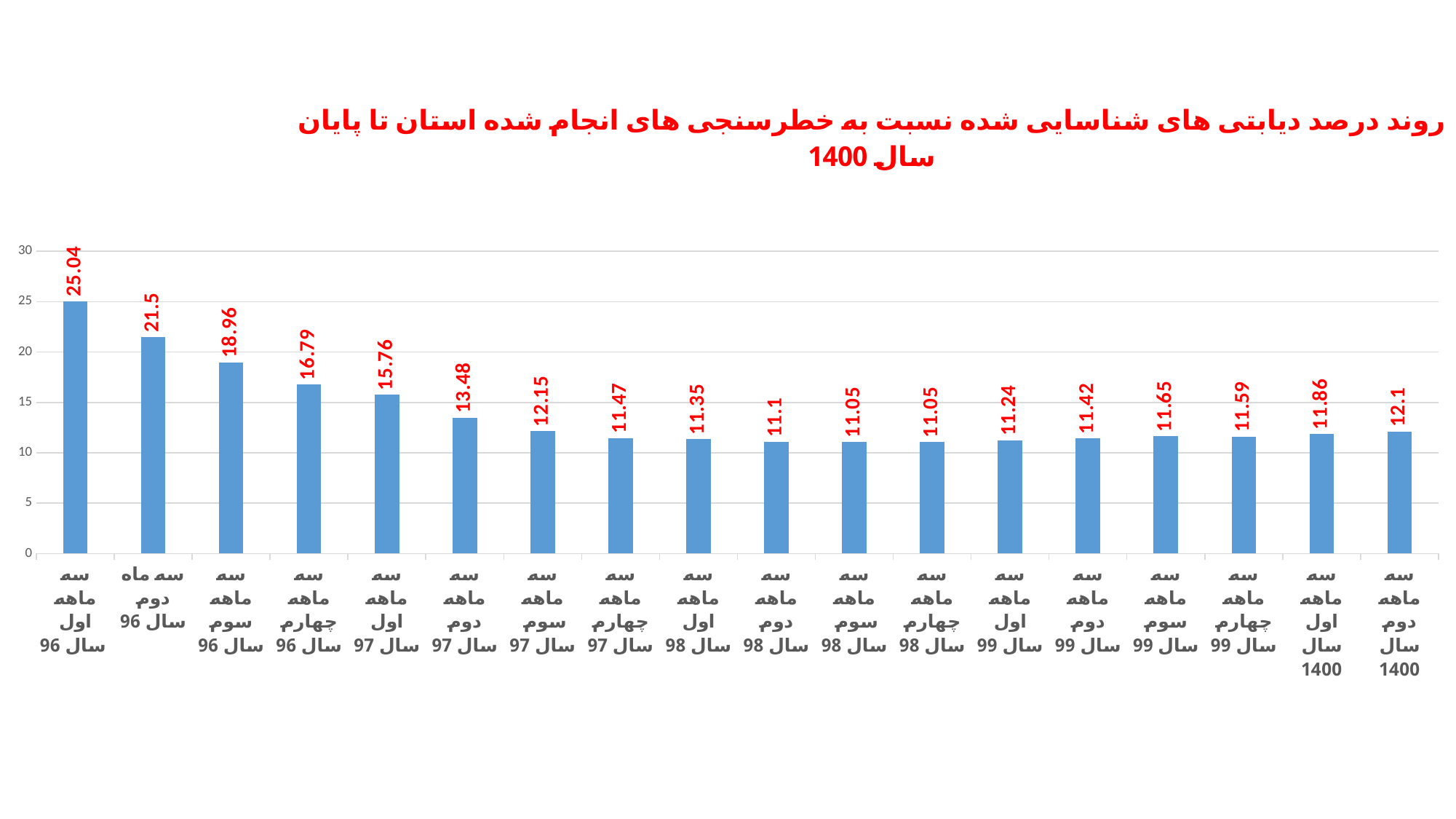
Do the values generally rise or fall from سه ماهه اول سال 96 to سه ماهه سوم سال 98? fall What is the lowest value shown in the chart? 11.05 What type of chart is shown on the slide? bar chart What colour are the bars in the chart? blue Which category has the highest value? سه ماهه اول سال 96 Which is larger: the value for سه ماهه اول سال 97 or the value for سه ماهه دوم سال 97? سه ماهه اول سال 97 What is the value for سه ماهه چهارم سال 97 (fourth quarter of 97)? 11.47 How many bars (categories) are plotted in the chart? 18 What is the value for سه ماهه دوم سال 1400 (second quarter of 1400)? 12.1 What is the difference between the values for سه ماهه اول سال 96 (25.04) and سه ماه دوم سال 96 (21.5)? 3.54 What is the value for سه ماهه اول سال 96 (first quarter of 96)? 25.04 Is the value for سه ماهه سوم سال 96 greater or less than 15? greater